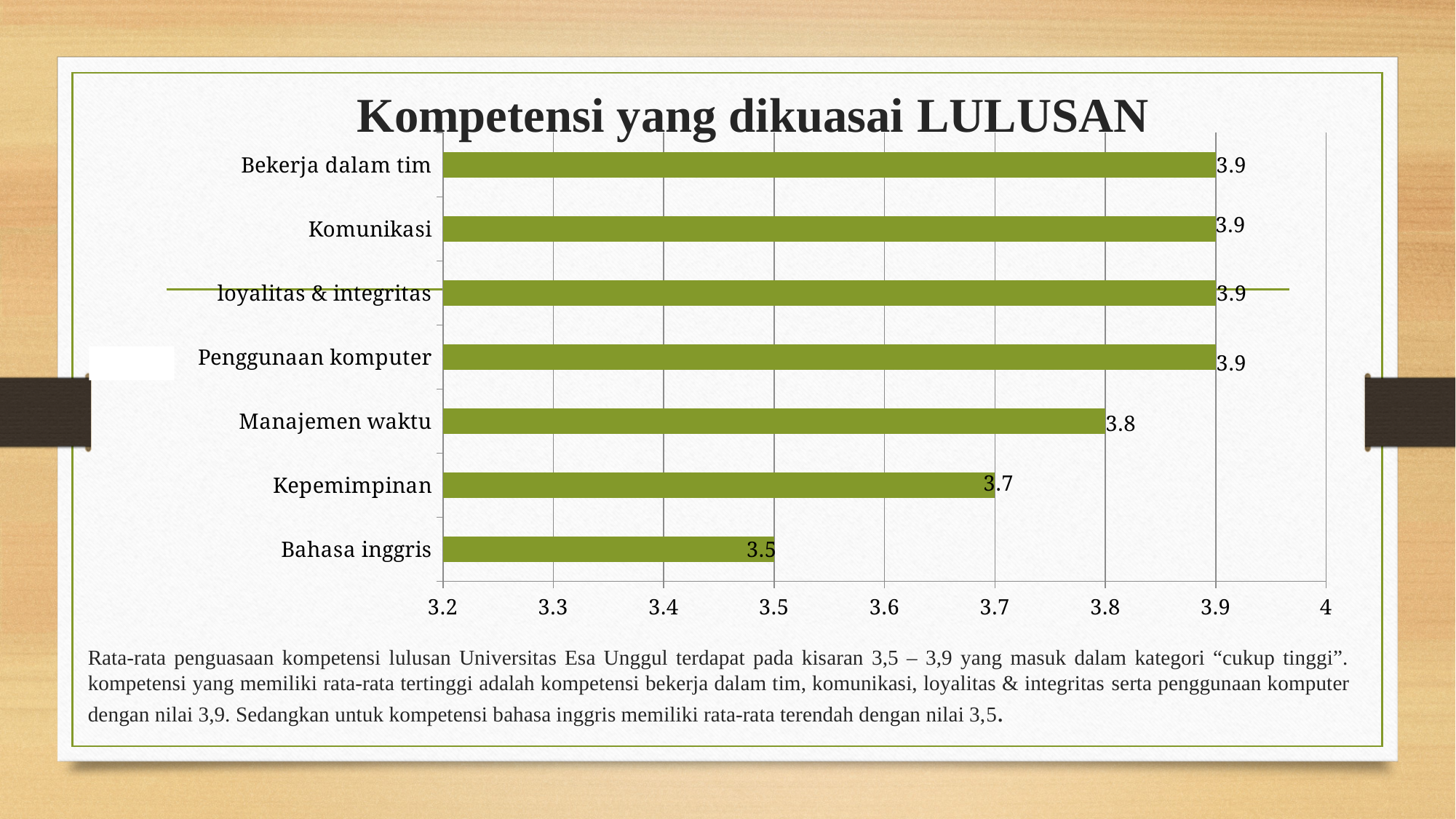
What kind of chart is shown on the slide? bar chart How many categories are shown in the chart? 7 What is the value for Kepemimpinan? 3.7 What is the difference between the values for Manajemen waktu and Bahasa inggris? 0.3 Which category has the lowest value? Bahasa inggris Which is larger, the value for Manajemen waktu or the value for Kepemimpinan? Manajemen waktu What is the value for Manajemen waktu? 3.8 What is the title of the chart? Kompetensi yang dikuasai LULUSAN What is the value for Komunikasi? 3.9 Is the value for Bahasa inggris greater or less than 3.6? less What is the difference between the values for Bekerja dalam tim and Kepemimpinan? 0.2 What is the value for Bahasa inggris? 3.5